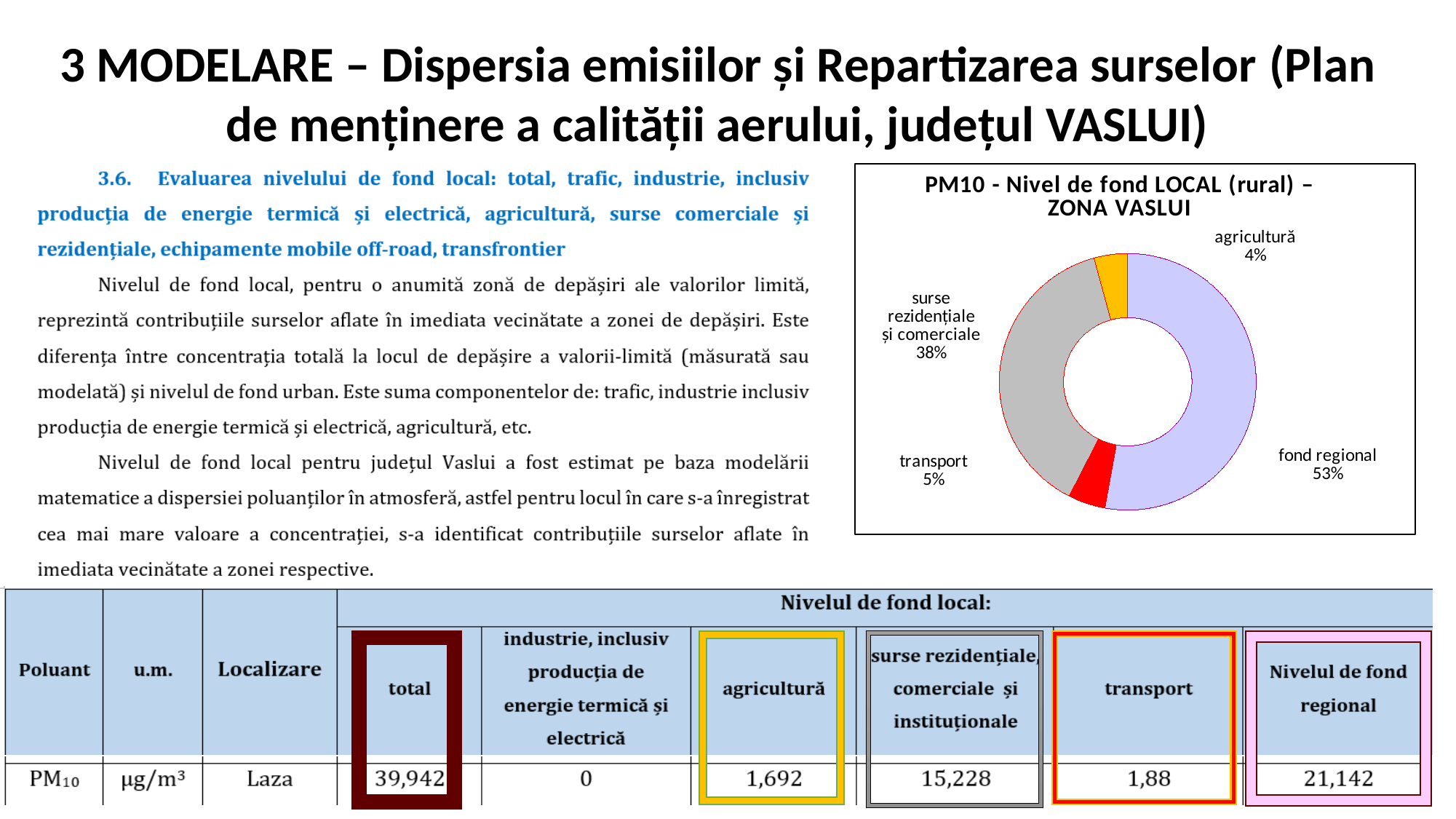
Which category has the largest share of the pie? fond regional What percentage is shown for agricultură? 4% What percentage is shown for surse rezidențiale și comerciale? 38% What kind of chart is shown on the slide? doughnut (pie) chart Which category has the smallest share of the pie? agricultură What percentage is shown for transport? 5% How many categories are shown in the pie chart? 4 How many percentage points larger is fond regional than surse rezidențiale și comerciale? 15 percentage points Which has the larger share, transport or agricultură? transport What share of the pie does fond regional account for? 53% What is the combined share of fond regional and surse rezidențiale și comerciale? 91% What is the title of the chart? PM10 - Nivel de fond LOCAL (rural) – ZONA VASLUI